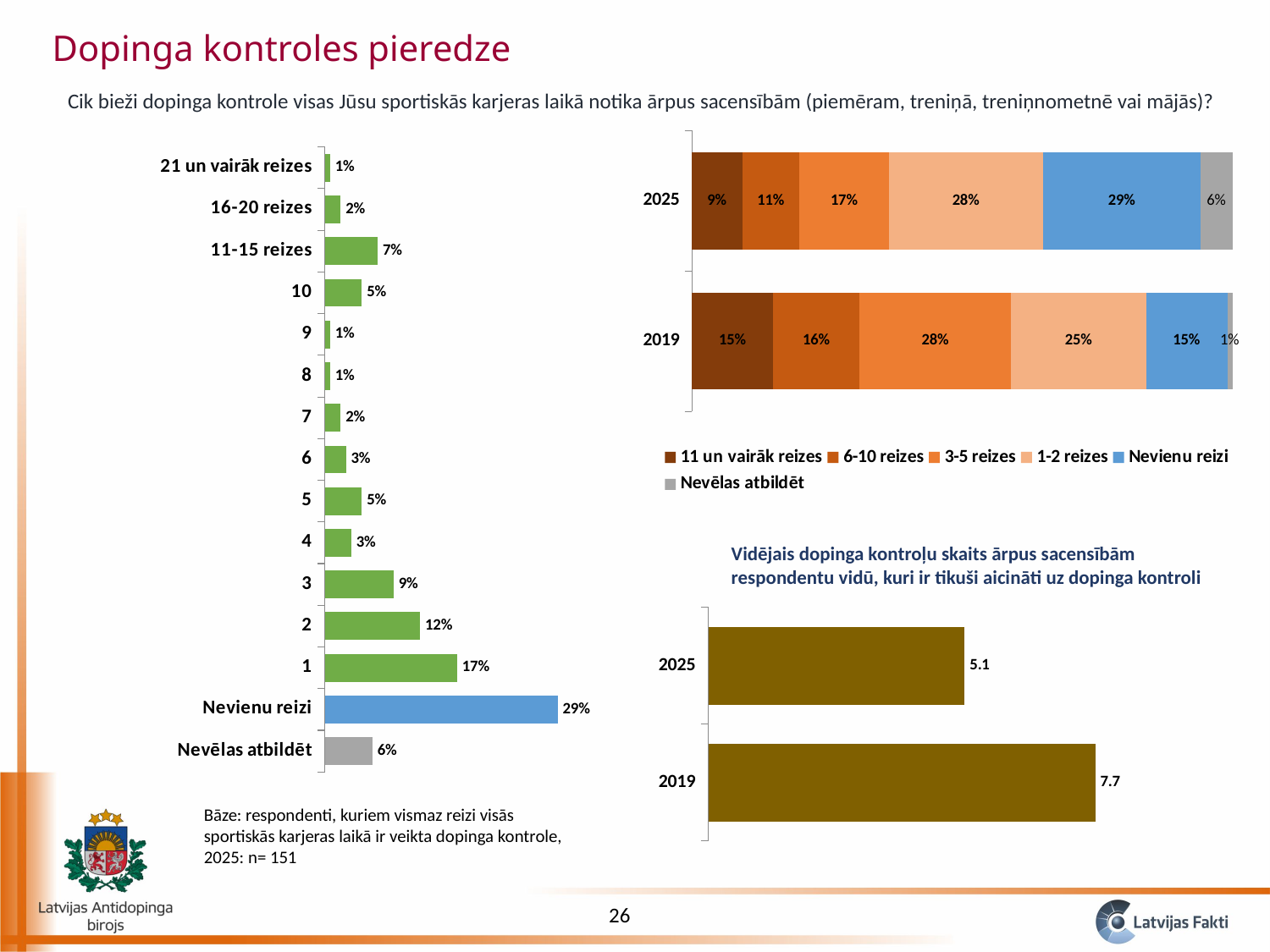
In the left bar chart, what is the value for "Nevienu reizi"? 29% In the chart titled "Vidējais dopinga kontroļu skaits ārpus sacensībām...", what is the difference between the 2019 and 2025 values? 2.6 In the stacked bar chart at the top right, what is the value of the "3-5 reizes" segment for 2019? 28% How many categories are shown in the left bar chart? 15 In the chart titled "Vidējais dopinga kontroļu skaits ārpus sacensībām...", what is the value for 2019? 7.7 In the stacked bar chart at the top right, what is the value of the "Nevienu reizi" segment for 2025? 29% In the stacked bar chart at the top right, what is the total of the 2025 bar? 100% In the left bar chart, which is larger: the value for "3" or the value for "11-15 reizes"? 3 In the left bar chart, what is the difference between the values for "1" and "2"? 5% In the left bar chart, which category has the highest value? Nevienu reizi What type of chart is the chart at the bottom right of the slide? Bar chart How many series does the legend of the stacked bar chart at the top right list? 6